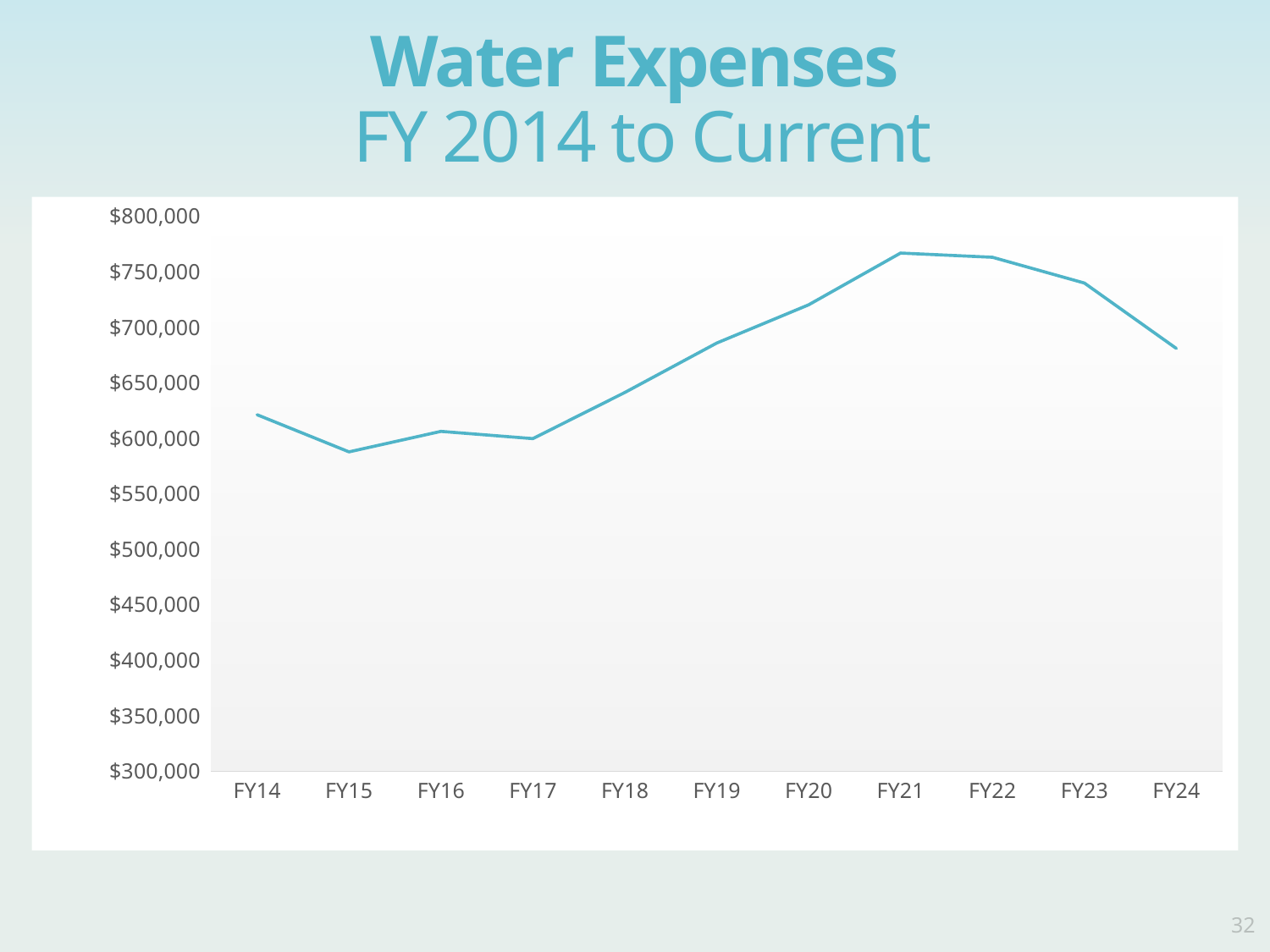
Is the value for FY21 greater or less than $750,000? greater Which is larger, the value for FY21 or the value for FY14? FY21 Is the value for FY15 greater or less than $600,000? less Is the value for FY20 greater or less than $700,000? greater Do the values rise or fall from FY22 to FY24? fall Which is larger, the value for FY24 or the value for FY17? FY24 Which fiscal year has the lowest water expenses? FY15 How many fiscal years are plotted on the x axis? 11 What kind of chart is shown on the slide? Line chart Do the values rise or fall from FY17 to FY21? rise